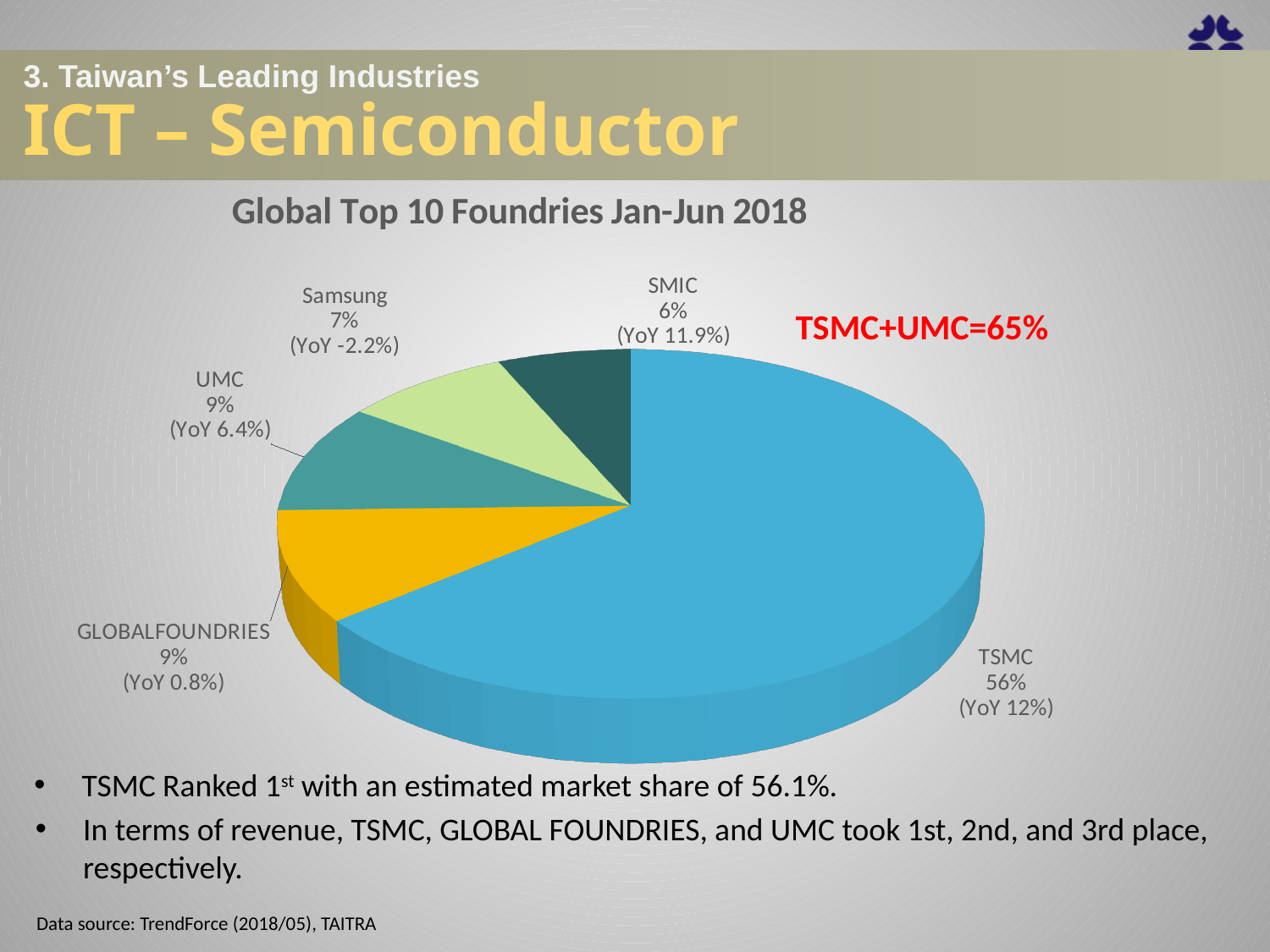
What is the title of the chart? Global Top 10 Foundries Jan-Jun 2018 What is the YoY figure shown for UMC? 6.4% Which foundry has the smallest slice of the pie? SMIC What is the YoY figure shown for Samsung? -2.2% What share of the pie does Samsung hold? 7% How many foundries are labelled on the pie chart? 5 What kind of chart is shown on the slide? pie chart What share of the pie does SMIC hold? 6% What is the difference in percentage points between TSMC's share and UMC's share? 47 What share of the pie does TSMC hold? 56% Which has the larger share, Samsung or SMIC? Samsung Which foundry has the largest slice of the pie? TSMC